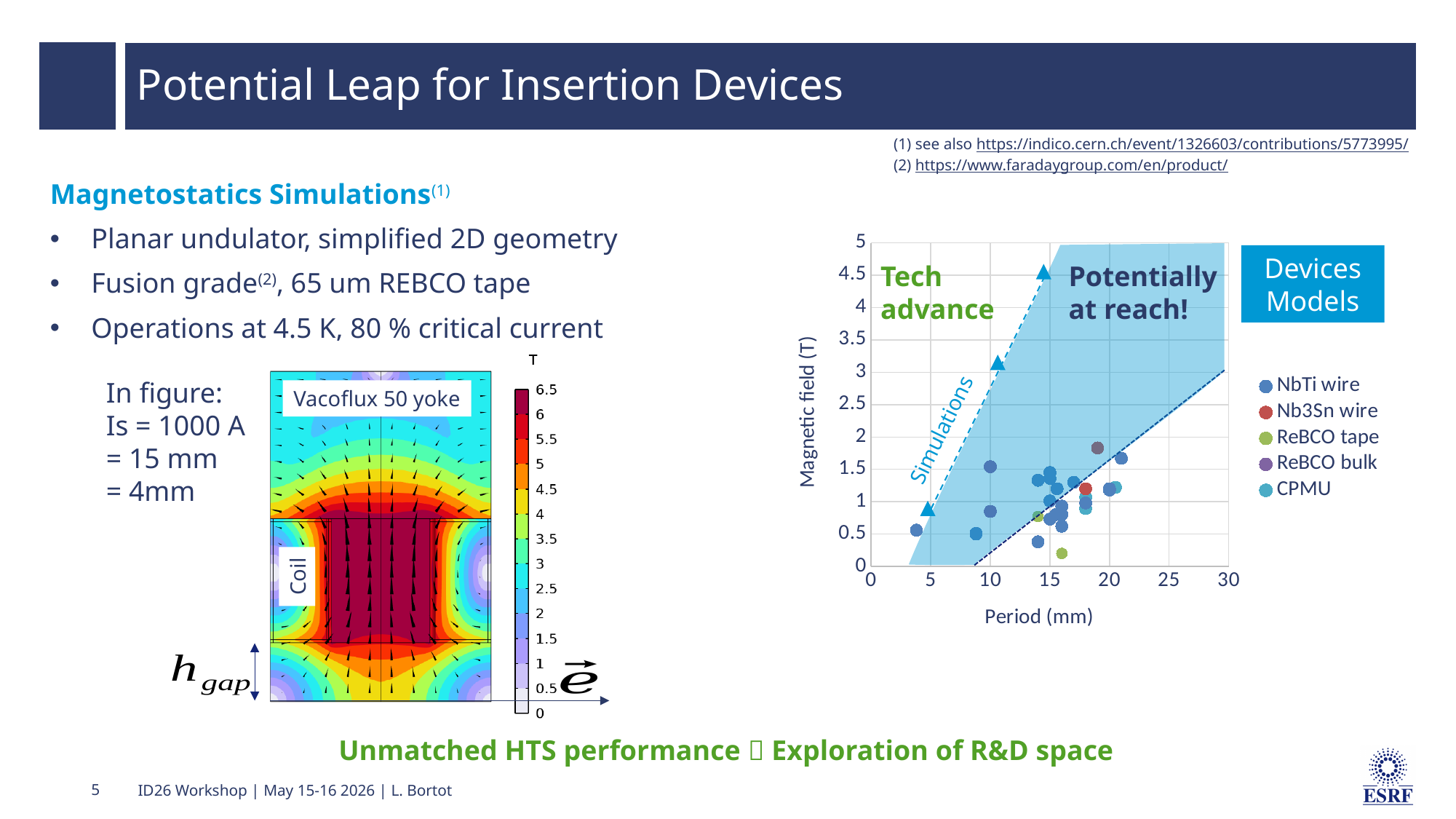
In the scatter chart, is the magnetic field of the lowest ReBCO tape point greater or less than 0.5? less What is the x-axis title of the scatter chart? Period (mm) How many ReBCO tape points are plotted in the scatter chart? 2 What kind of chart is the chart on the right of the slide? Scatter chart In the scatter chart, which marker series reaches the highest magnetic field? Simulations How many series does the legend of the scatter chart list? 5 In the scatter chart, is the magnetic field of the lowest Simulations triangle greater or less than 1? less In the scatter chart, is the magnetic field of the highest Simulations triangle greater or less than 4? greater What is the y-axis title of the scatter chart? Magnetic field (T)